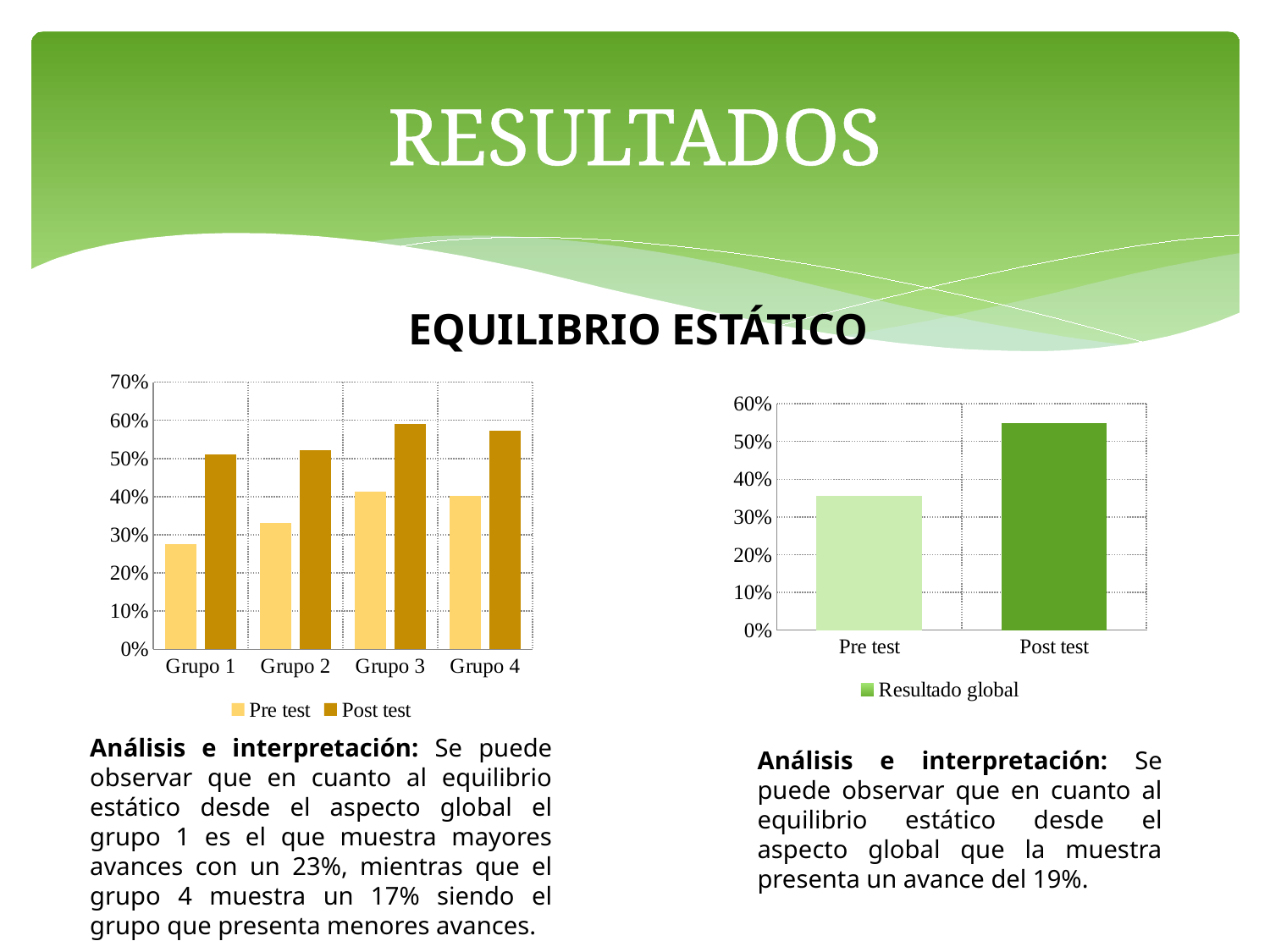
In the right chart, is the value for Pre test greater or less than 40%? less In the left chart, is the Pre test value for Grupo 1 greater or less than 30%? less How many groups are shown on the x axis of the left chart? 4 In the left chart, which Pre test value is larger: Grupo 2 or Grupo 4? Grupo 4 In the left chart, which group has the lowest Pre test value? Grupo 1 In the left chart, which is larger for Grupo 1: the Pre test value or the Post test value? Post test What kind of chart is the chart on the left of the slide? bar chart How many series does the legend of the left chart list? 2 In the left chart, is the Post test value for Grupo 3 greater or less than 50%? greater What is the single legend entry of the right chart? Resultado global What kind of chart is the chart on the right of the slide? bar chart In the right chart, which category has the highest value? Post test